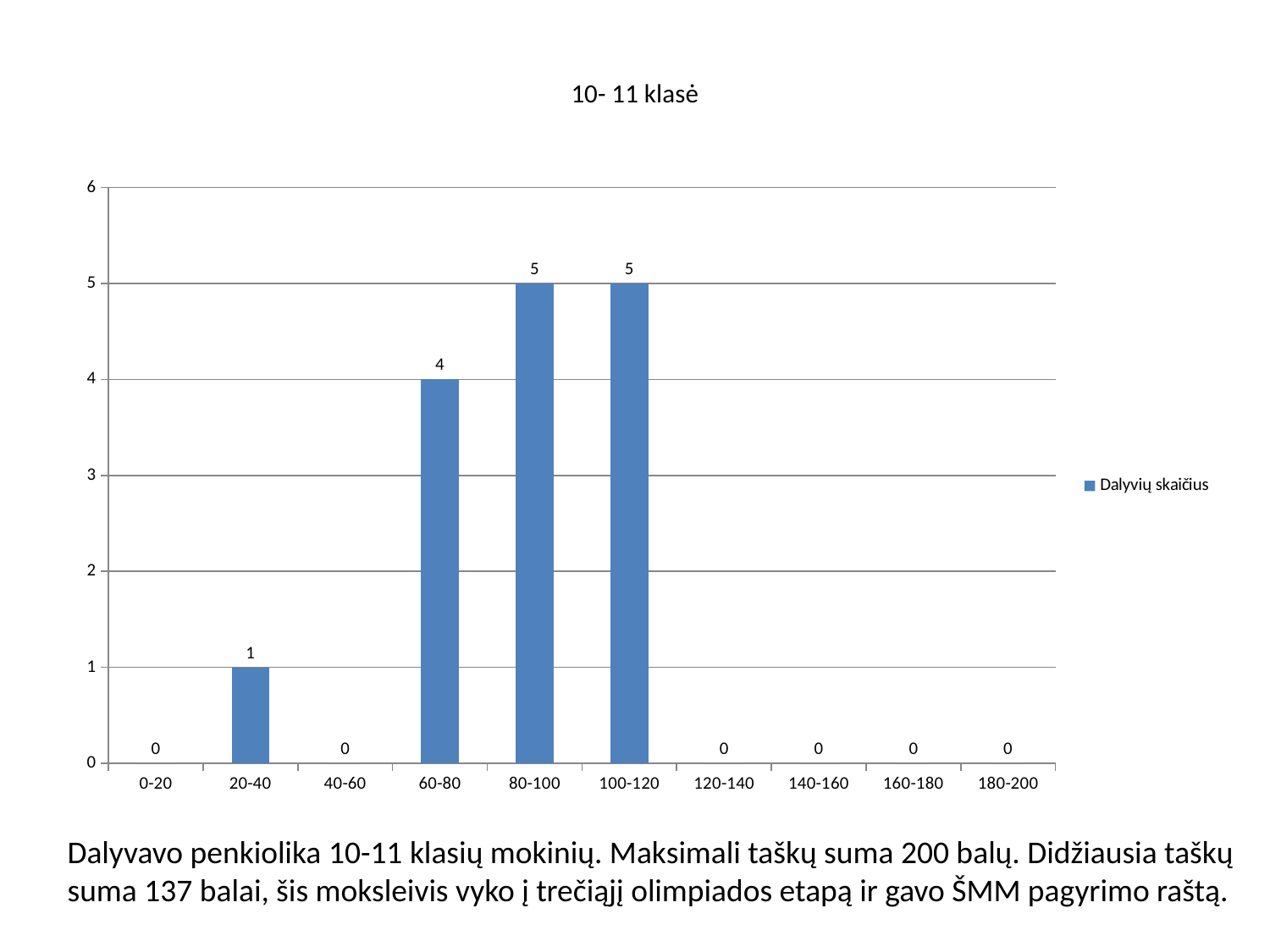
What is the difference between the values for 60-80 and 20-40? 3 What is the value for the 140-160 category? 0 What is the value for the 20-40 category? 1 How many categories are shown on the x axis? 10 What is the title of the chart? 10- 11 klasė What is the difference between the values for 80-100 and 60-80? 1 What is the value for the 60-80 category? 4 What kind of chart is shown on the slide? bar chart Which is larger, the value for 20-40 or the value for 60-80? 60-80 What is the value for the 80-100 category? 5 Which is larger, the value for 60-80 or the value for 100-120? 100-120 Is the value for 60-80 greater or less than 3? greater